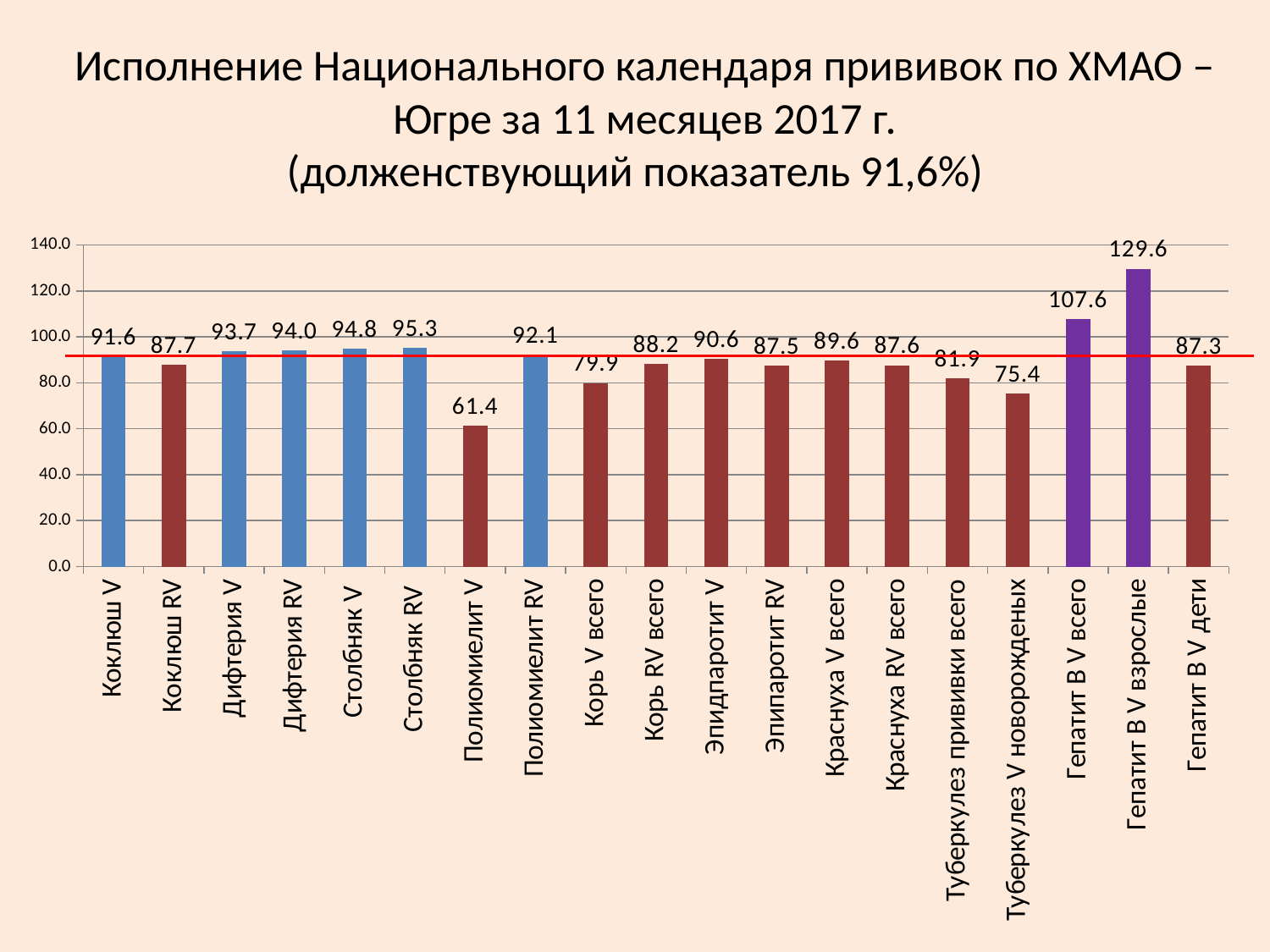
Which category has the highest value? Гепатит В V взрослые What is the value for Столбняк RV? 95.3 What is the value for Туберкулез V новорожденных? 75.4 What kind of chart is shown on the slide? Bar chart Which category has the lowest value? Полиомиелит V What is the difference between the values for Гепатит В V взрослые and Гепатит В V всего? 22.0 Which is larger, the value for Корь V всего or the value for Корь RV всего? Корь RV всего What is the difference between the values for Дифтерия RV and Коклюш RV? 6.3 What is the value for Полиомиелит V? 61.4 How many categories are shown on the x axis? 19 What is the value for Гепатит В V всего? 107.6 What is the target value (долженствующий показатель) stated in the chart title? 91,6%